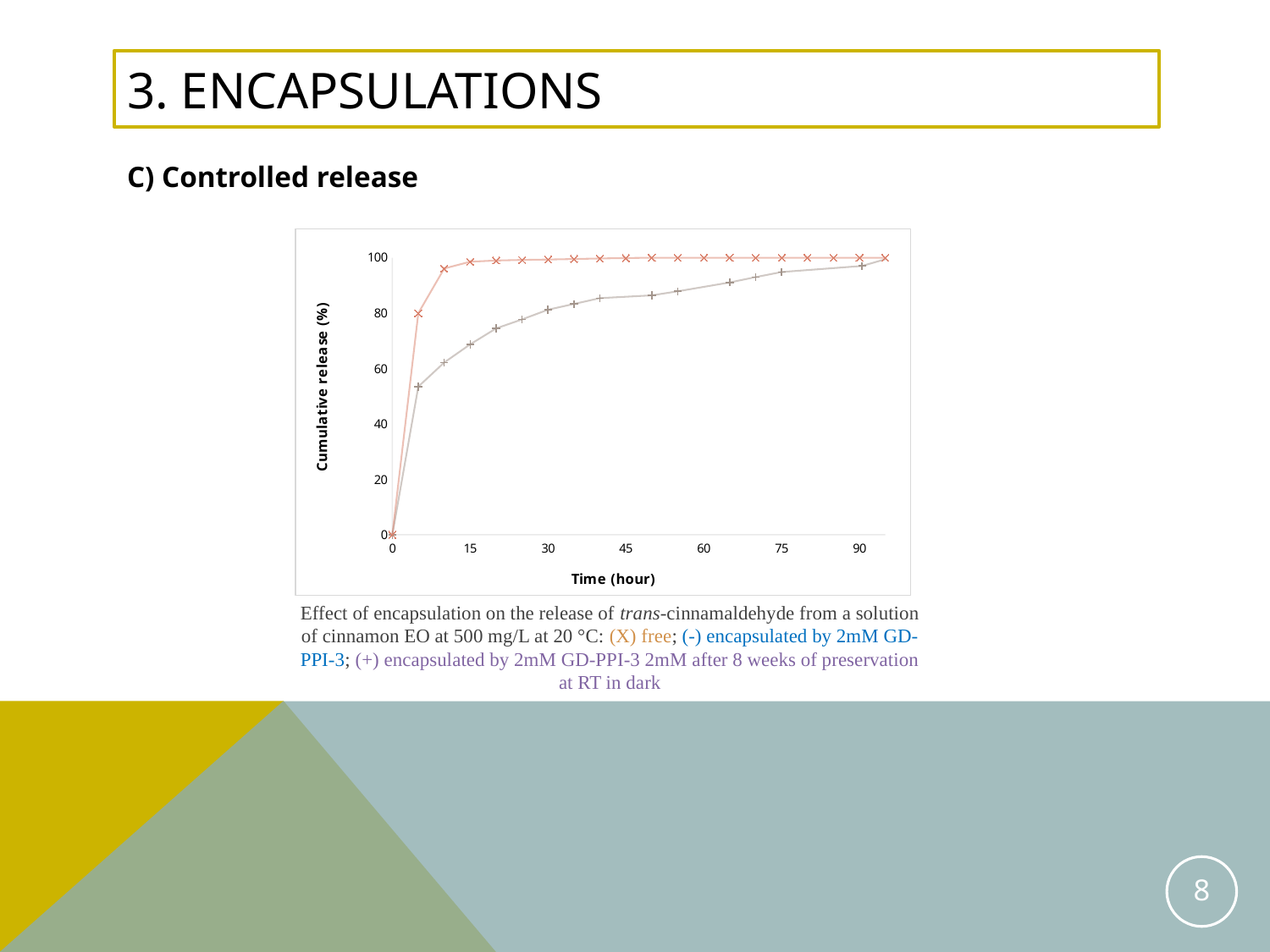
What is the label of the y axis of the chart? Cumulative release (%) What is the highest value shown on the y axis of the chart? 100 Do the cumulative release values rise or fall as time increases along the x axis? rise Is the cumulative release of the +-marker (encapsulated) series at 5 hours greater or less than 40? greater At 30 hours, which series shows the higher cumulative release: the X-marker (free) series or the +-marker (encapsulated) series? the X-marker (free) series How many data series are plotted on the chart? 2 Is the cumulative release of the +-marker (encapsulated) series at 15 hours greater or less than 80? less Is the cumulative release of the +-marker (encapsulated) series at 45 hours greater or less than 80? greater What kind of chart is shown on the slide? line chart What is the cumulative release (%) of both series at time 0 hours? 0 What is the label of the x axis of the chart? Time (hour)